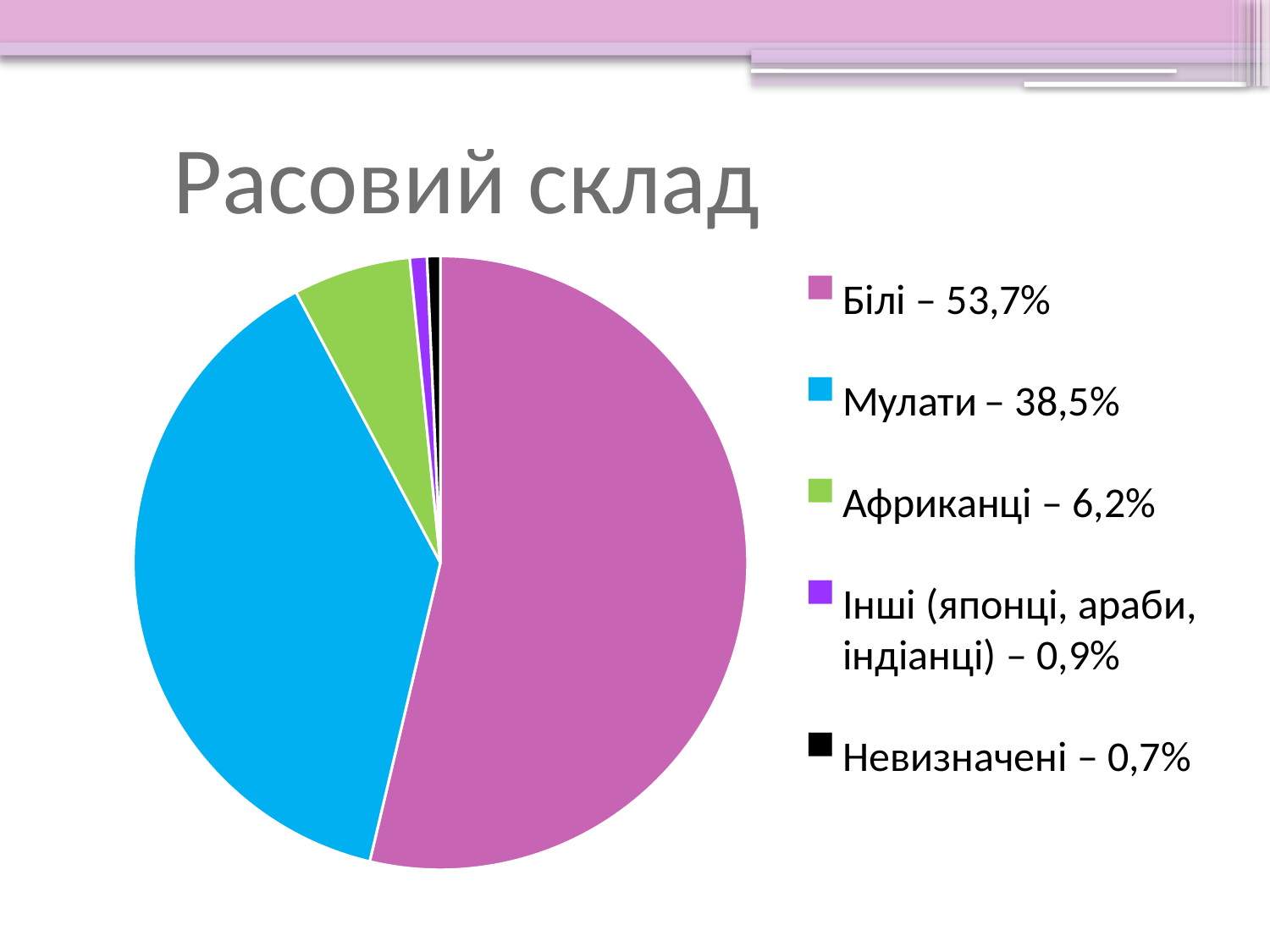
What colour is the slice for Мулати? blue Which category has the largest slice of the pie? Білі Which category has the smallest slice of the pie? Невизначені What share of the pie is Африканці? 6,2% What share of the pie is Білі? 53,7% What is the difference between the shares of Білі and Мулати? 15,2% Which is larger, the share of Африканці or the share of Інші (японці, араби, індіанці)? Африканці What share of the pie is Мулати? 38,5% What kind of chart is shown on the slide? pie chart What is the title of the chart on the slide? Расовий склад How many slices does the pie chart have? 5